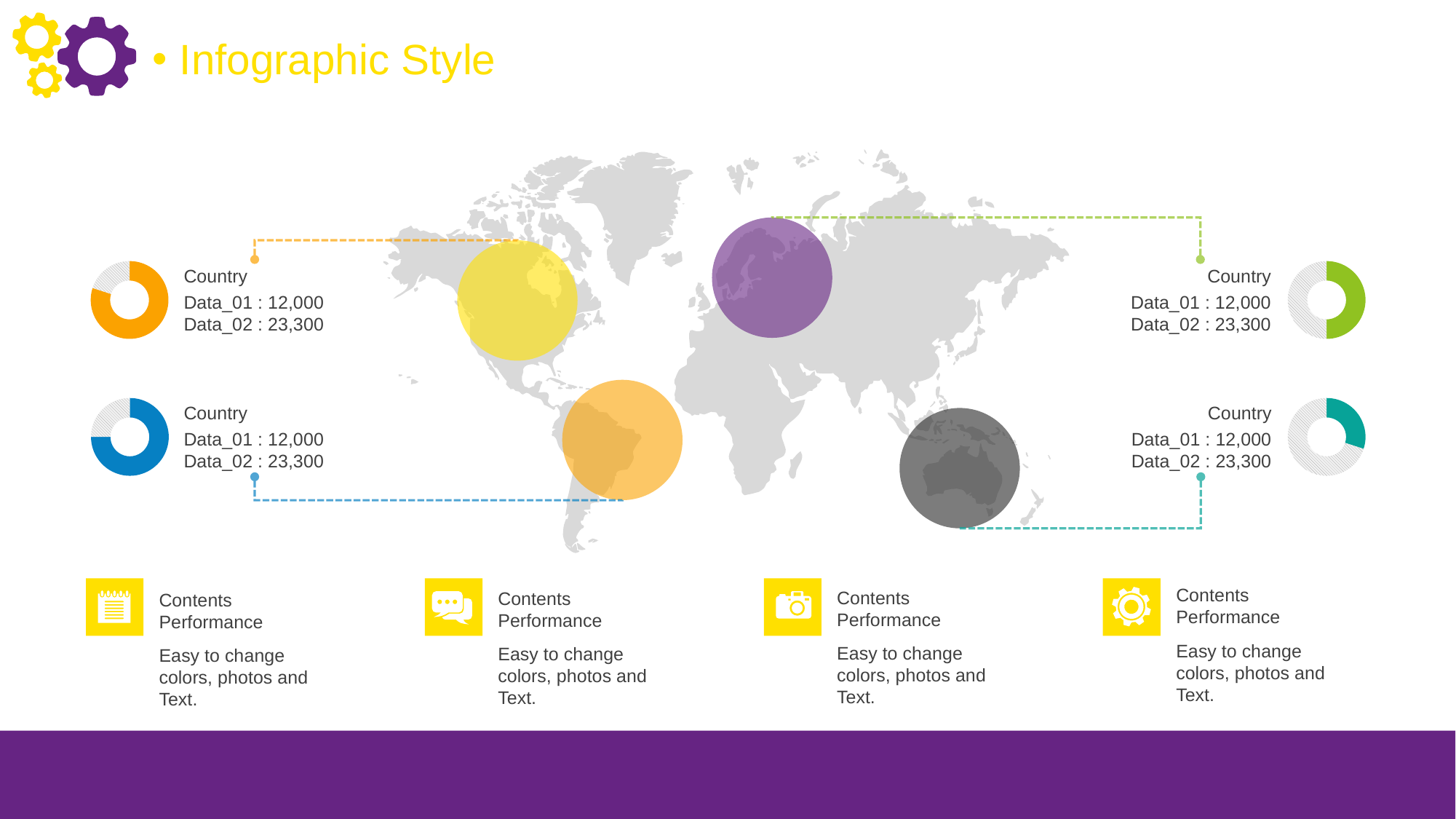
What label is printed above the data values next to each doughnut chart? Country What is the Data_02 value printed next to the green doughnut chart on the right? 23,300 What colour is the doughnut chart at the bottom left of the slide? blue What kind of chart is the orange chart on the left side of the slide? doughnut chart For the orange doughnut chart, what is the difference between Data_02 and Data_01? 11,300 For the blue doughnut chart, which is larger, Data_01 or Data_02? Data_02 What is the Data_01 value printed next to the teal doughnut chart at the bottom right? 12,000 What is the Data_01 value printed next to the blue doughnut chart? 12,000 What is the Data_02 value printed next to the orange doughnut chart? 23,300 What is the Data_01 value printed next to the orange doughnut chart? 12,000 How many doughnut charts are shown on the slide? 4